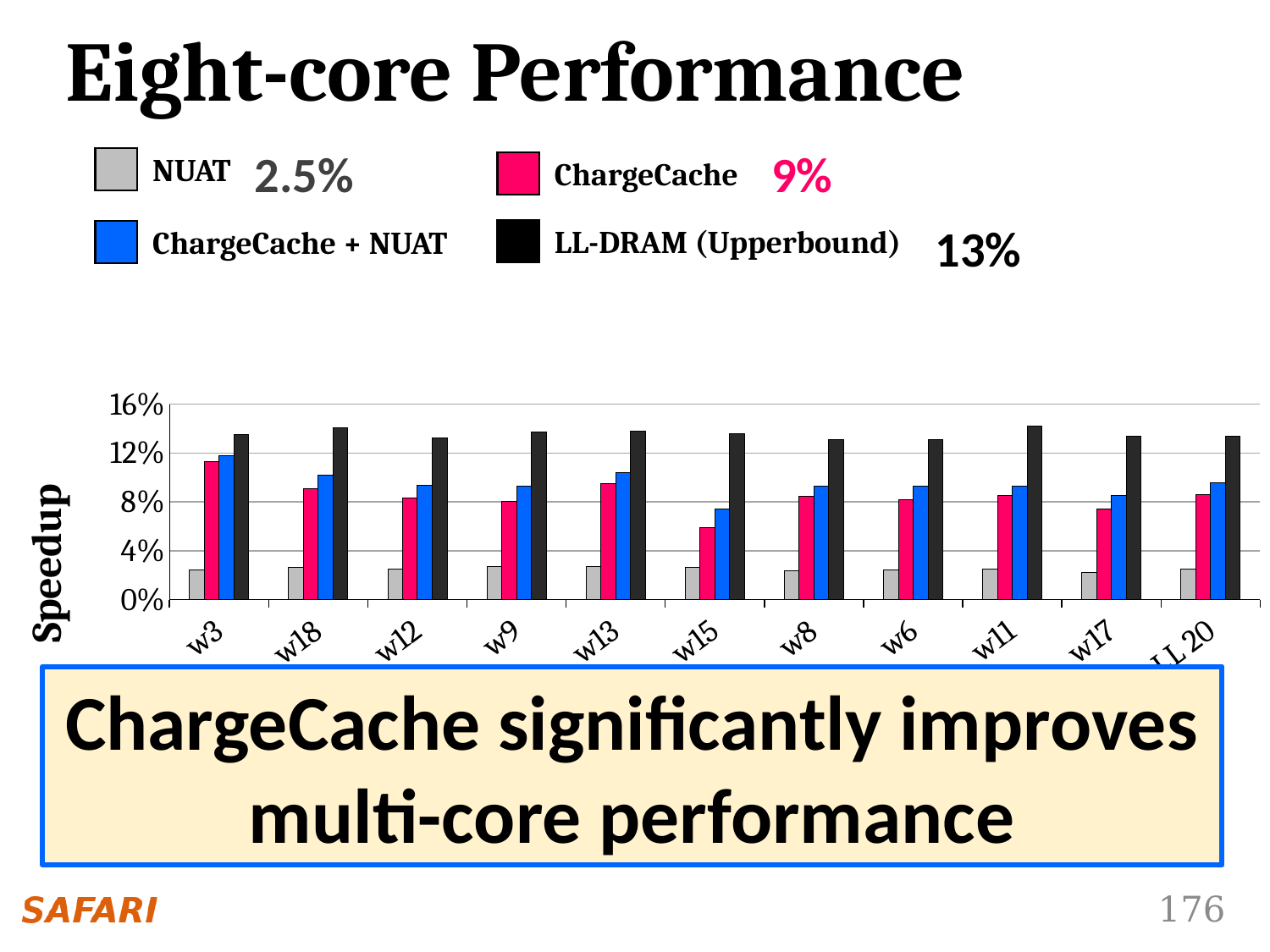
Is the NUAT speedup for w3 greater or less than 4%? less What average speedup value is printed next to ChargeCache in the legend? 9% Is the LL-DRAM (Upperbound) speedup for w18 greater or less than 12%? greater How many groups of bars (workloads) are plotted along the x axis? 11 Is the ChargeCache speedup for w15 greater or less than 8%? less For w18, which is larger: the NUAT speedup or the ChargeCache speedup? ChargeCache What is the label of the y axis? Speedup What kind of chart is shown on the slide? bar chart How many series does the legend list? 4 Which workload has the highest ChargeCache speedup? w3 Which workload has the lowest ChargeCache speedup? w15